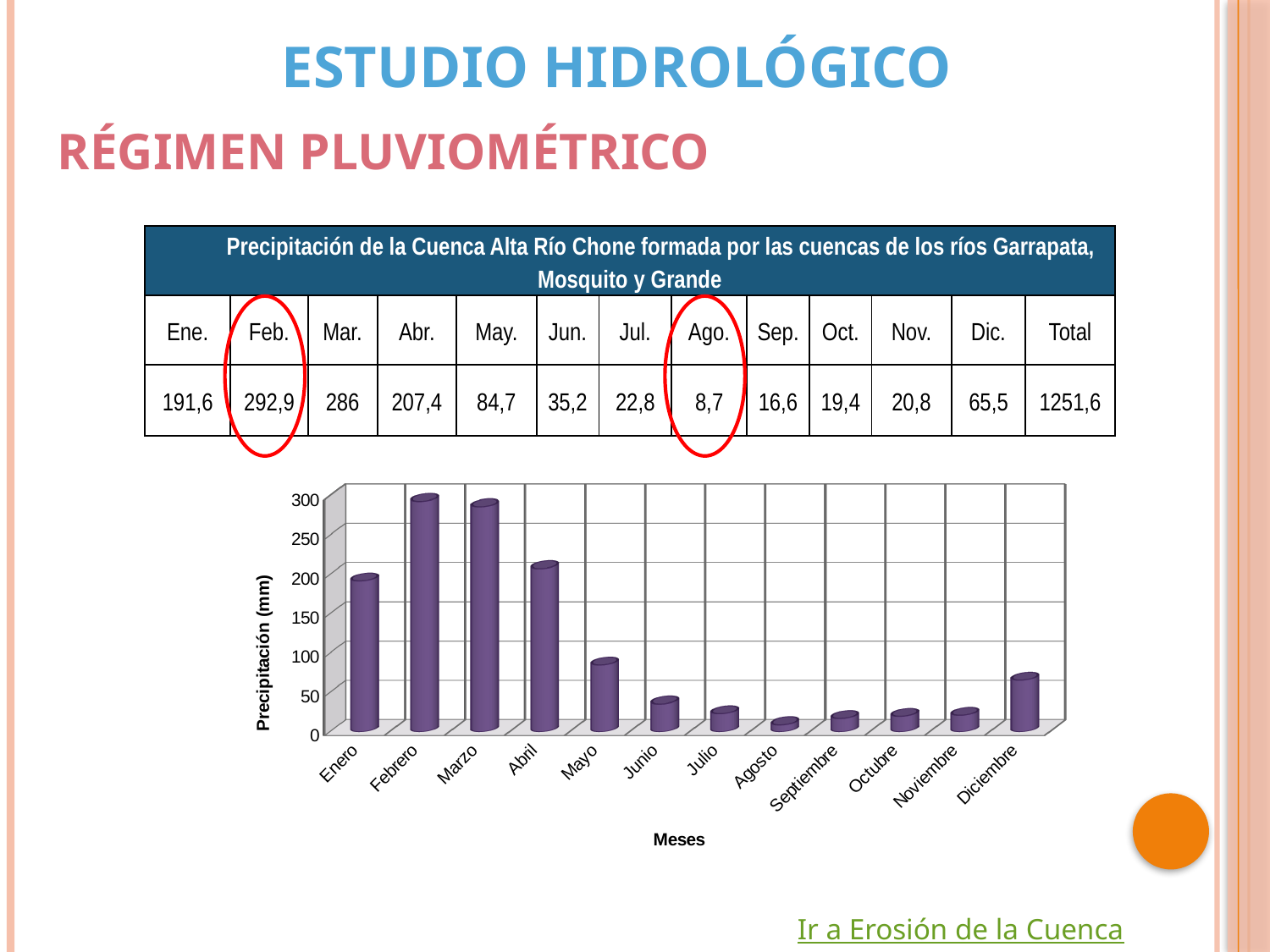
Which month has the highest precipitation in the chart? Febrero What is the precipitation value for Agosto according to the slide? 8,7 Is the precipitation for Enero greater or less than 150? greater Which is larger, the precipitation for Abril or for Diciembre? Abril How many months (categories) are plotted on the x axis of the chart? 12 Is the precipitation for Mayo greater or less than 100? less What is the difference between the precipitation for Febrero and Agosto, using the values shown on the slide? 284,2 Do the precipitation values generally rise or fall from Febrero to Agosto? fall Which month has the lowest precipitation in the chart? Agosto What is the label of the y axis of the chart? Precipitación (mm) What type of chart is shown on the slide? bar chart What is the precipitation value for Febrero according to the slide? 292,9